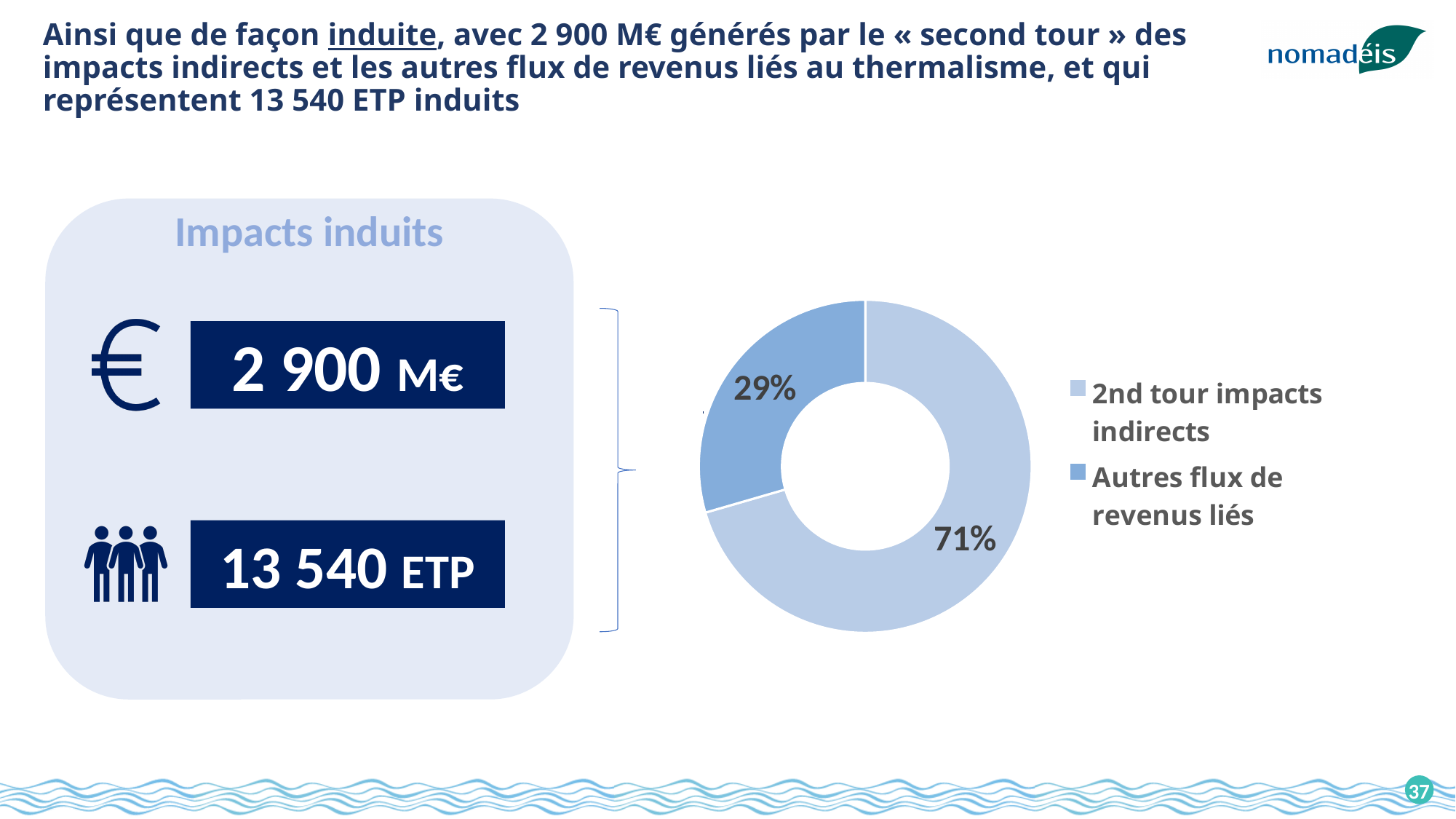
Which category has the smallest share in the doughnut chart? Autres flux de revenus liés What share of the doughnut chart is labelled "Autres flux de revenus liés"? 29% How many entries does the legend of the doughnut chart list? 2 What is the difference in percentage points between the "2nd tour impacts indirects" slice and the "Autres flux de revenus liés" slice? 42 percentage points What share of the doughnut chart is labelled "2nd tour impacts indirects"? 71% Which is larger: the share for "2nd tour impacts indirects" or the share for "Autres flux de revenus liés"? 2nd tour impacts indirects Which legend entry is shown in the darker blue colour in the doughnut chart? Autres flux de revenus liés How many slices does the doughnut chart have? 2 What is the total of the two slices shown in the doughnut chart? 100% What kind of chart is shown on the slide? Doughnut chart Is the share for "Autres flux de revenus liés" greater or less than 50%? less Which category has the largest share in the doughnut chart? 2nd tour impacts indirects